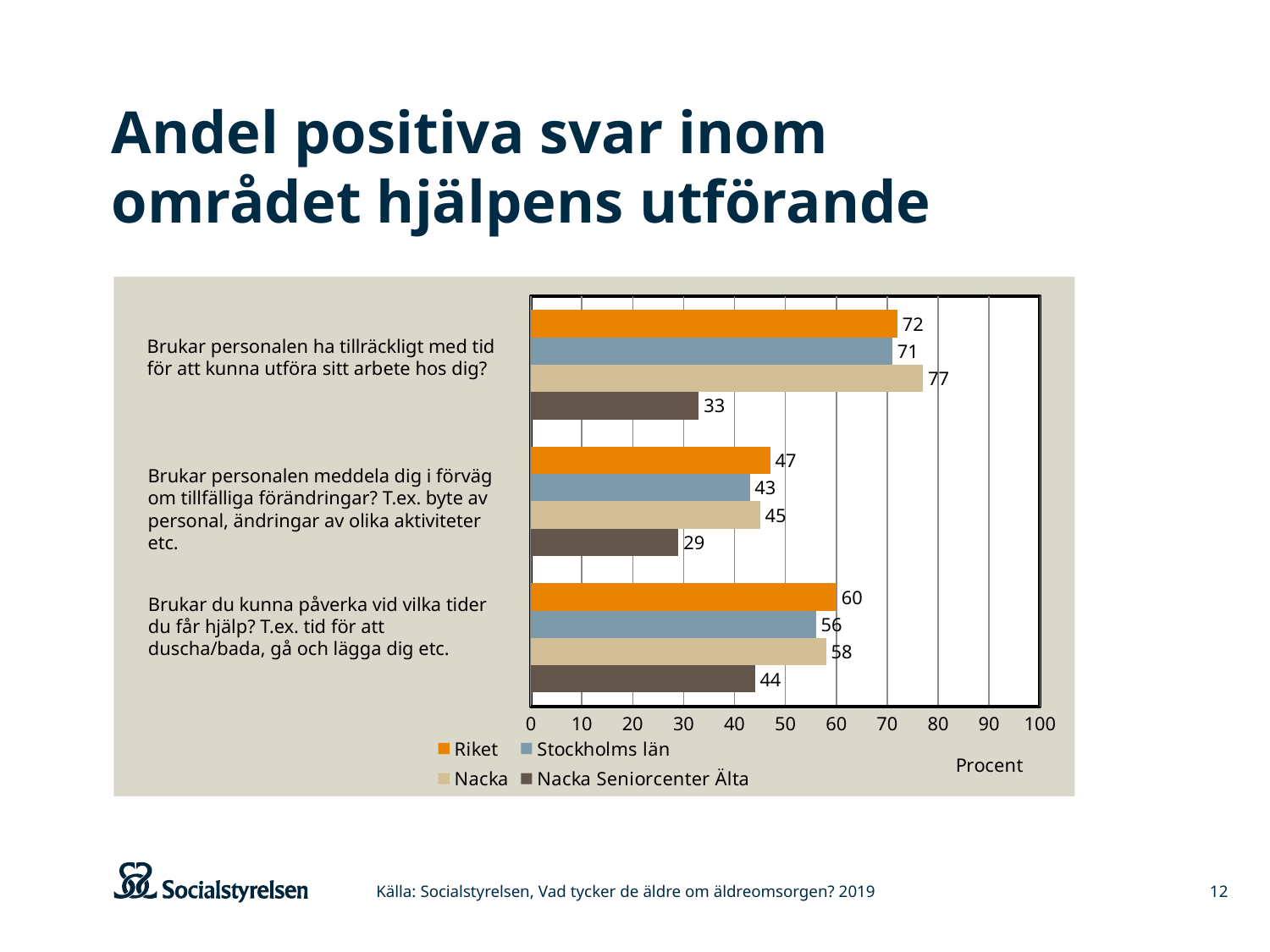
Which series has the highest value on the question "Brukar personalen ha tillräckligt med tid för att kunna utföra sitt arbete hos dig?"? Nacka What is the value for Nacka Seniorcenter Älta on the question "Brukar personalen meddela dig i förväg om tillfälliga förändringar?"? 29 How many question categories are shown on the chart? 3 Which series has the lowest value on the question "Brukar du kunna påverka vid vilka tider du får hjälp?"? Nacka Seniorcenter Älta What is the difference between Nacka and Nacka Seniorcenter Älta on the question "Brukar personalen ha tillräckligt med tid för att kunna utföra sitt arbete hos dig?"? 44 How many series does the legend list? 4 Which is larger on the question "Brukar personalen meddela dig i förväg om tillfälliga förändringar?": Riket or Stockholms län? Riket What is the value for Nacka on the question "Brukar personalen ha tillräckligt med tid för att kunna utföra sitt arbete hos dig?"? 77 What is the value for Riket on the question "Brukar du kunna påverka vid vilka tider du får hjälp?"? 60 What kind of chart is shown on the slide? Bar chart Is the value for Nacka Seniorcenter Älta on the question "Brukar du kunna påverka vid vilka tider du får hjälp?" greater or less than 50? less What is the value for Stockholms län on the question "Brukar personalen ha tillräckligt med tid för att kunna utföra sitt arbete hos dig?"? 71